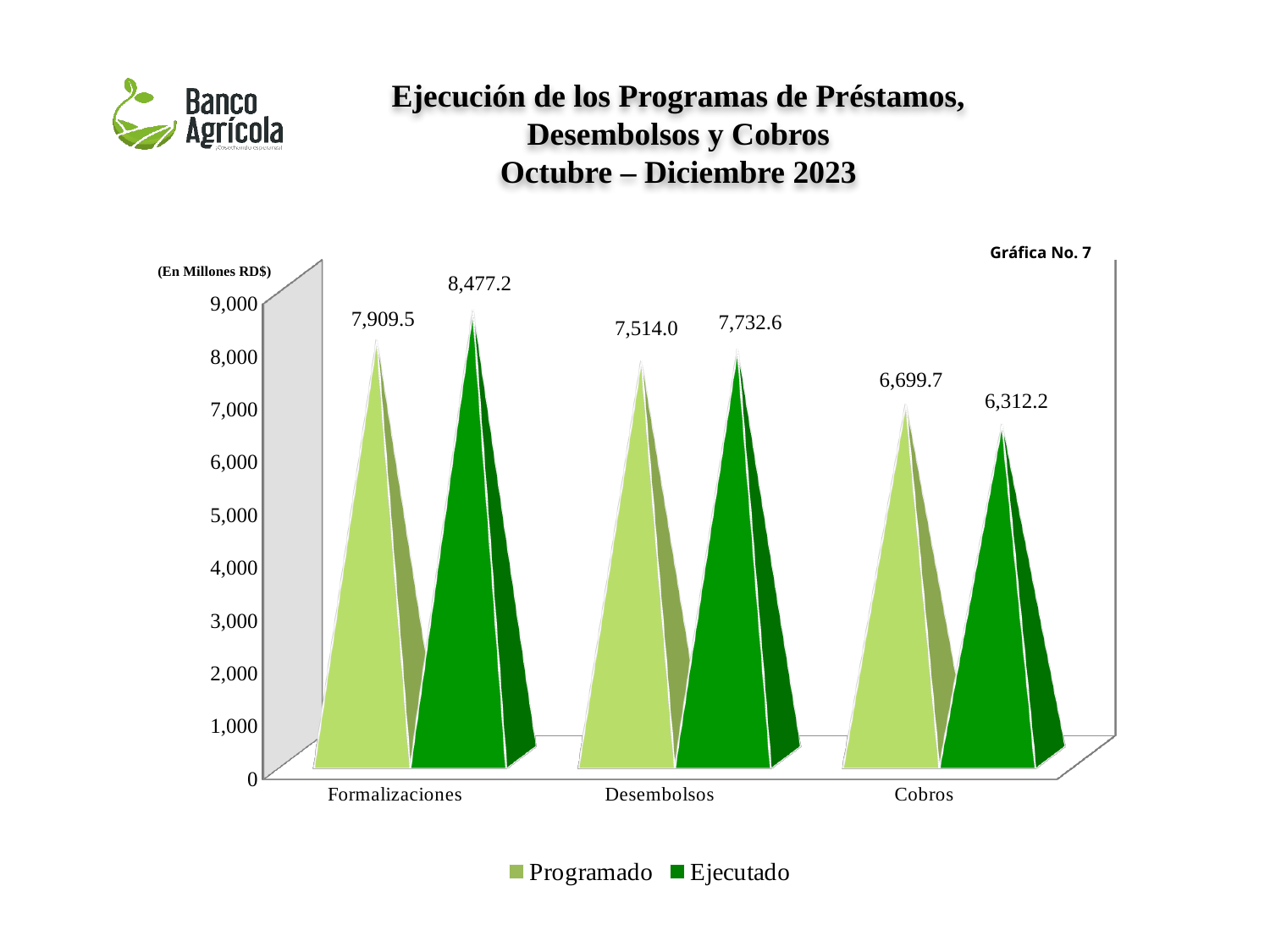
What is the Ejecutado value for Cobros? 6,312.2 Which category has the highest Ejecutado value? Formalizaciones What is the difference between the Programado and Ejecutado values for Cobros? 387.5 What unit is stated for the values in the chart? En Millones RD$ What is the Ejecutado value for Desembolsos? 7,732.6 What kind of chart is shown on the slide? Bar chart For Cobros, which is larger: Programado or Ejecutado? Programado What is the difference between the Ejecutado and Programado values for Formalizaciones? 567.7 What is the Programado value for Formalizaciones? 7,909.5 How many series does the legend list? 2 How many categories are shown on the x axis? 3 Which category has the lowest Programado value? Cobros